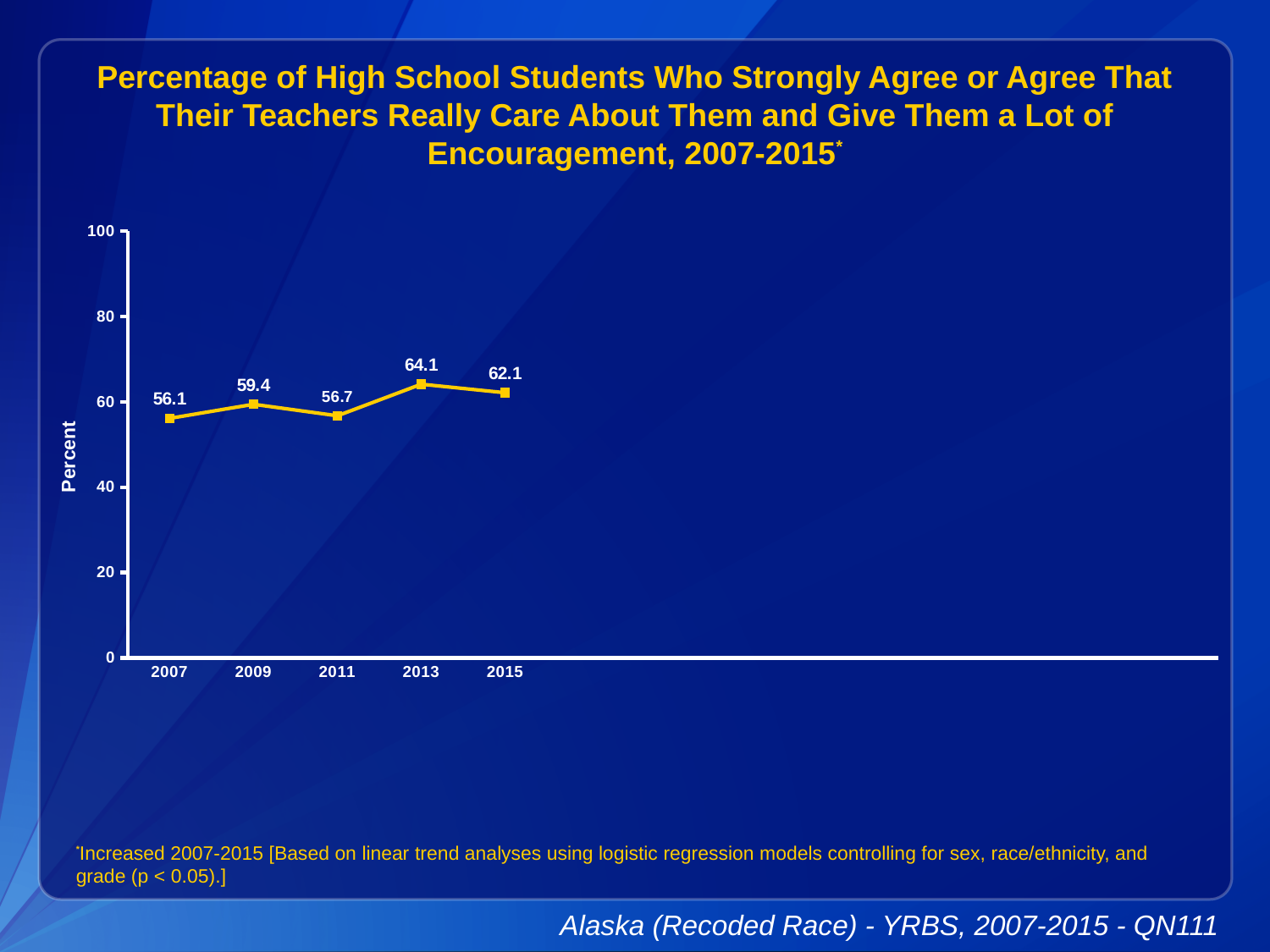
Overall, do the values rise or fall from 2007 to 2015? rise Is the value for 2013 greater or less than 60? greater Which year has the lowest value? 2007 Which is larger, the value for 2009 or the value for 2011? 2009 What is the value for 2015? 62.1 Which year has the highest value? 2013 How many years are plotted on the chart? 5 What is the value for 2007? 56.1 What is the difference between the values for 2013 and 2007? 8 What is the value for 2013? 64.1 What kind of chart is shown on the slide? line chart What is the label on the y axis? Percent